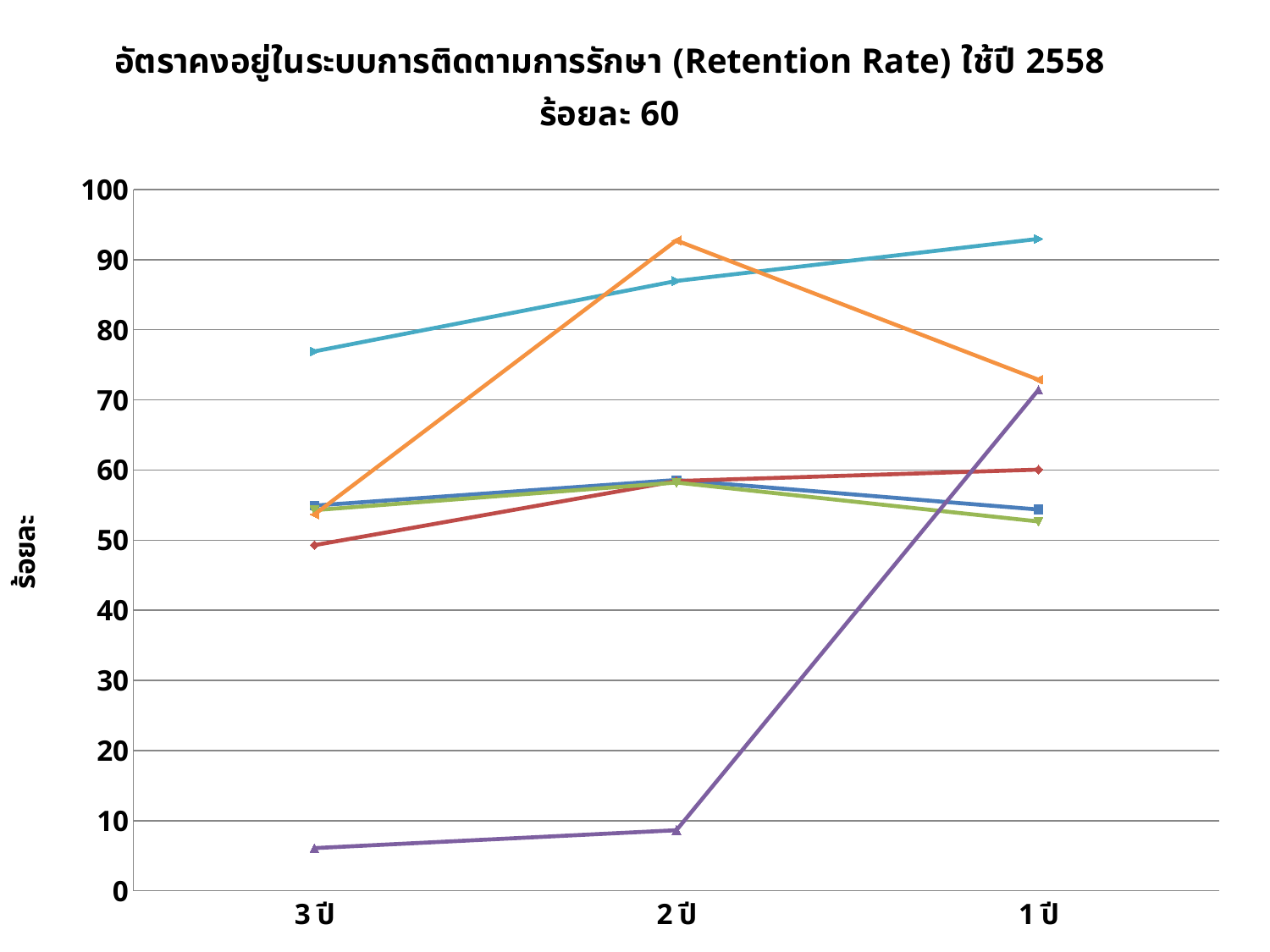
Is the value of the purple line at 3 ปี greater or less than 10? less Is the value of the light blue line at 1 ปี greater or less than 90? greater What is the title of the chart? อัตราคงอยู่ในระบบการติดตามการรักษา (Retention Rate) ใช้ปี 2558 ร้อยละ 60 Does the light blue line rise or fall from 3 ปี to 1 ปี? rise How many categories are shown on the x axis? 3 Is the value of the orange line at 2 ปี greater or less than 90? greater Which line has the highest value at 2 ปี? the orange line What is the label on the vertical axis? ร้อยละ What kind of chart is shown on the slide? line chart At 1 ปี, which is larger: the light blue line or the orange line? the light blue line Does the purple line rise or fall from 3 ปี to 1 ปี? rise